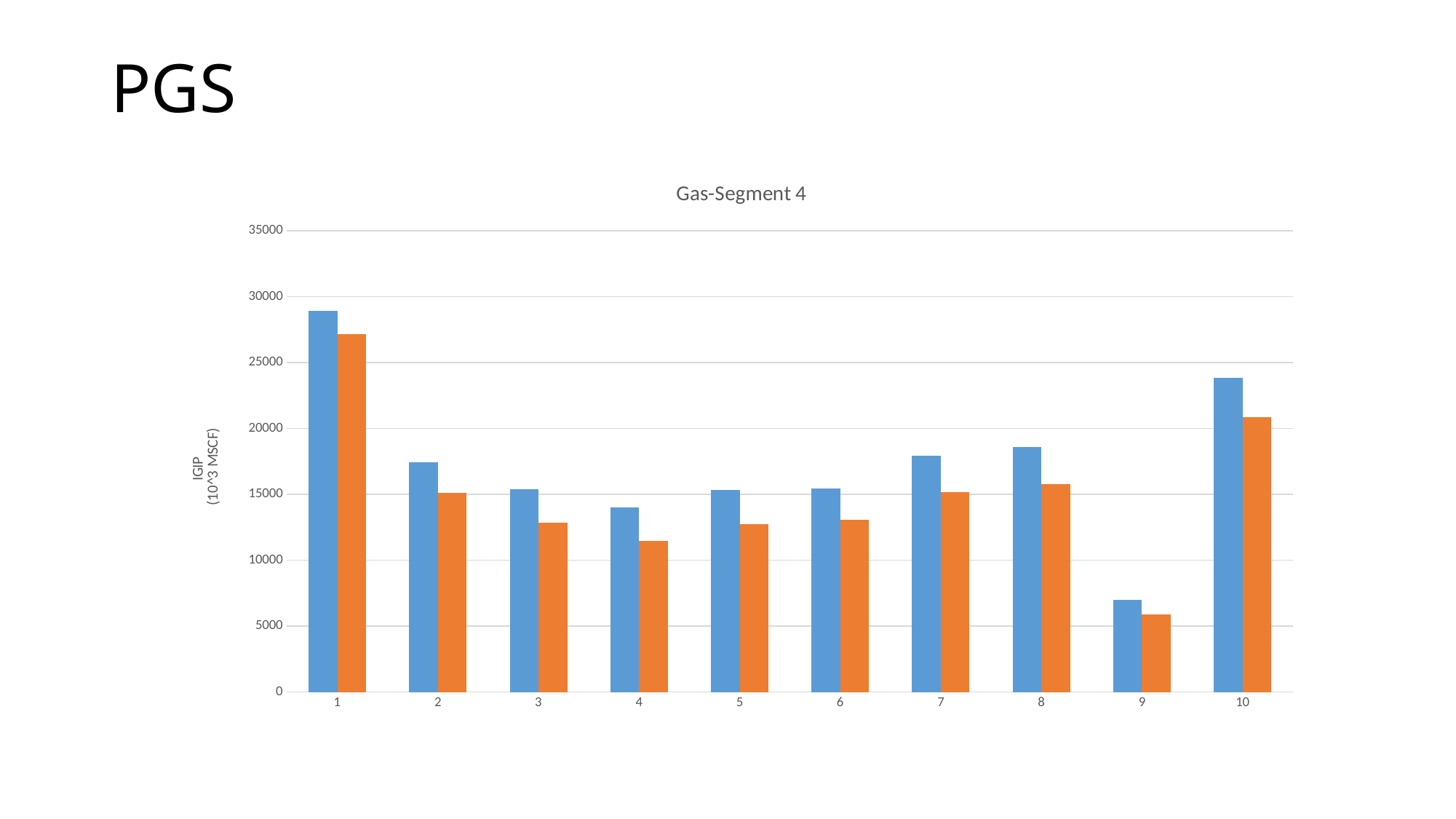
What is the label on the vertical axis of the chart? IGIP (10^3 MSCF) How many categories are shown on the x axis of the chart? 10 Is the blue bar for category 1 greater or less than 25000? greater What kind of chart is shown on the slide? bar chart Which category has the tallest blue bar? 1 How many bars are plotted for each category on the chart? 2 Is the blue bar for category 10 greater or less than 25000? less Is the orange bar for category 4 greater or less than 10000? greater Which category has the shortest blue bar? 9 For category 10, which bar is taller, the blue one or the orange one? blue Which category has the shortest orange bar? 9 What is the title of the chart? Gas-Segment 4